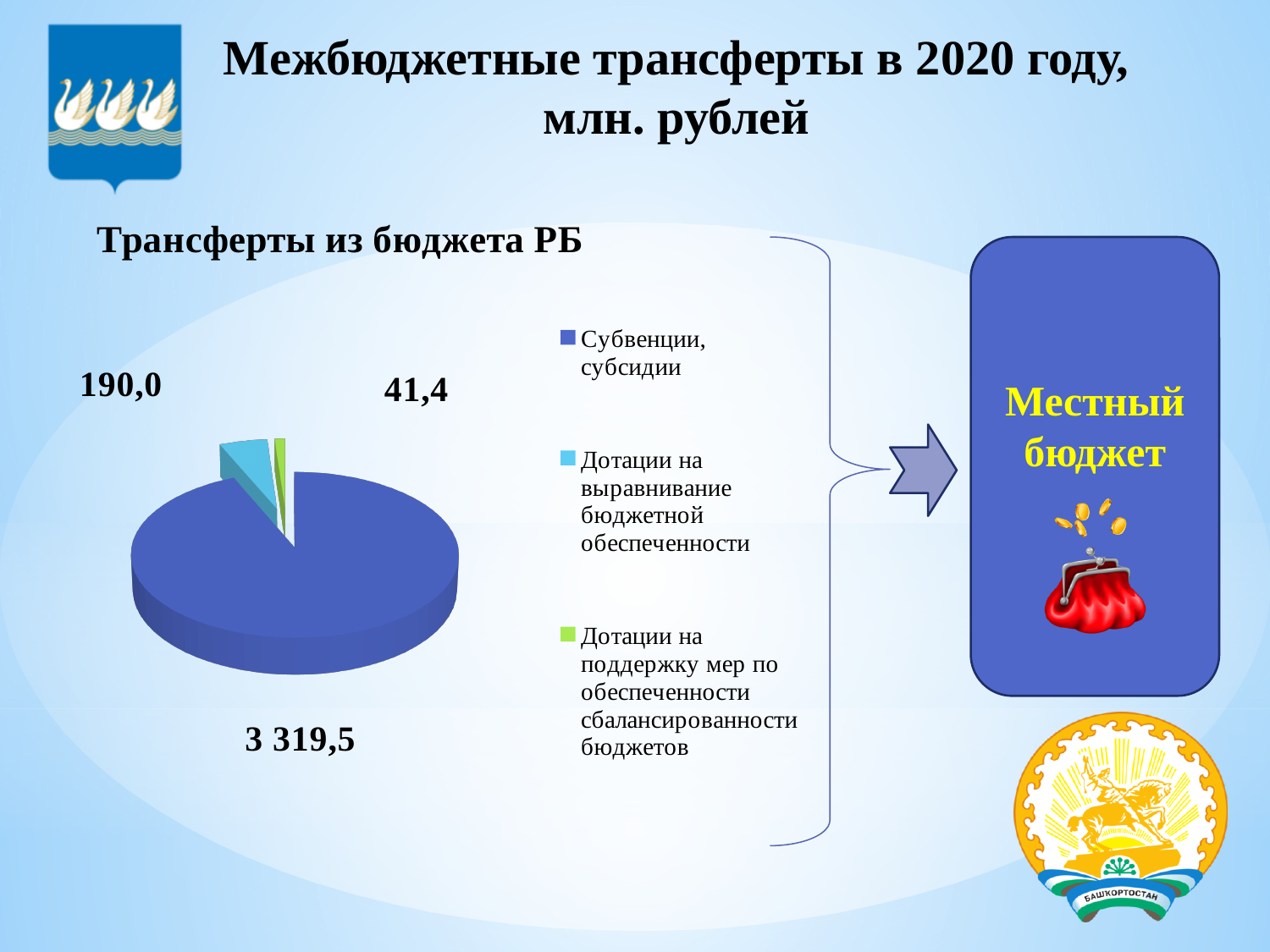
What colour is the slice for "Субвенции, субсидии" in the pie chart? Dark blue What is the value for "Субвенции, субсидии" in the pie chart? 3 319,5 What is the difference between the values for "Субвенции, субсидии" and "Дотации на выравнивание бюджетной обеспеченности"? 3 129,5 What is the difference between the values for "Дотации на выравнивание бюджетной обеспеченности" and "Дотации на поддержку мер по обеспеченности сбалансированности бюджетов"? 148,6 How many slices does the pie chart have? 3 Which category has the smallest slice in the pie chart? Дотации на поддержку мер по обеспеченности сбалансированности бюджетов What is the value for "Дотации на выравнивание бюджетной обеспеченности" in the pie chart? 190,0 How many entries does the legend of the pie chart list? 3 Which is larger in the pie chart: "Дотации на выравнивание бюджетной обеспеченности" or "Дотации на поддержку мер по обеспеченности сбалансированности бюджетов"? Дотации на выравнивание бюджетной обеспеченности What kind of chart is shown under the heading "Трансферты из бюджета РБ"? Pie chart What is the value for "Дотации на поддержку мер по обеспеченности сбалансированности бюджетов" in the pie chart? 41,4 Which category has the largest slice in the pie chart? Субвенции, субсидии